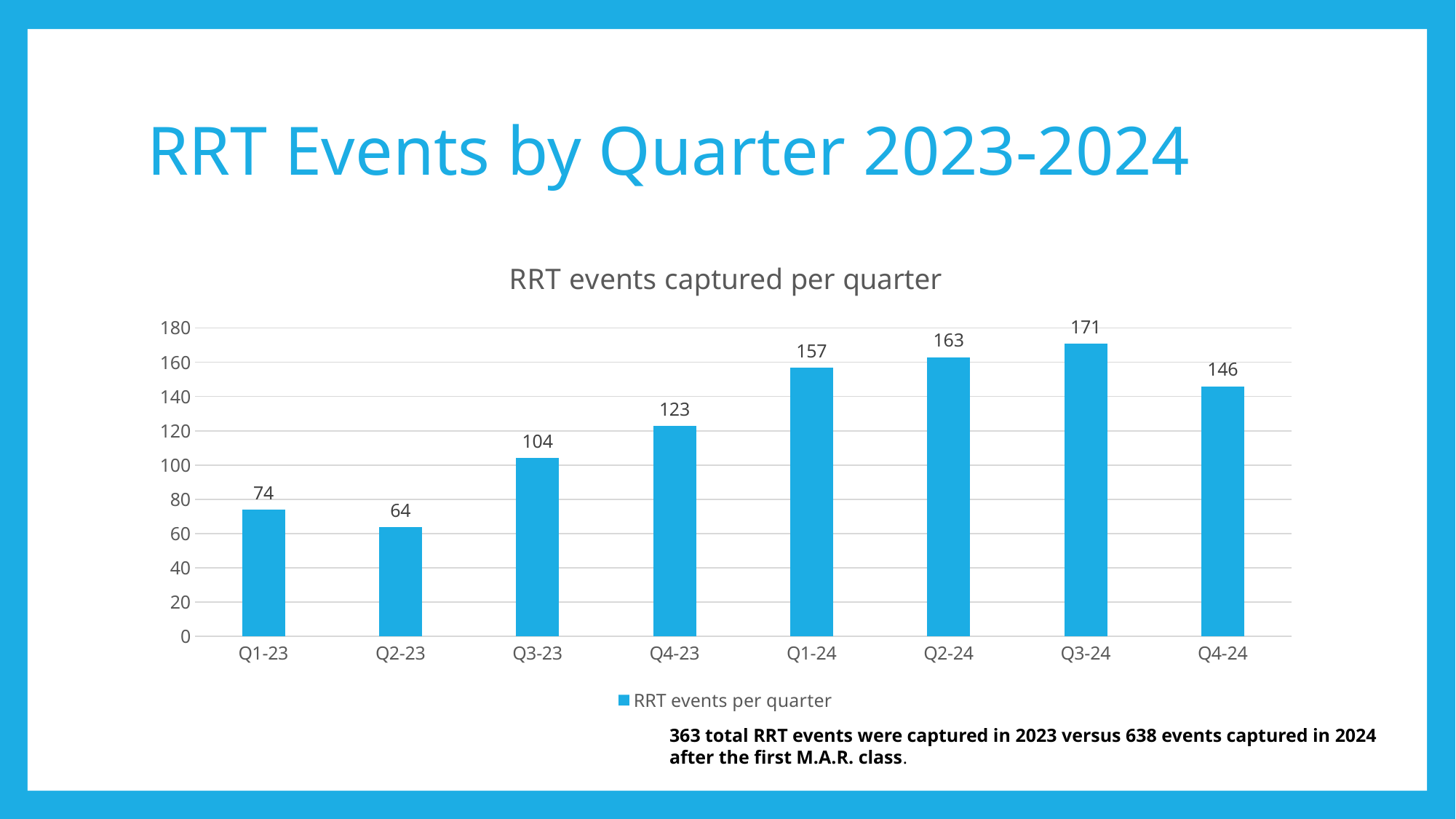
Is the value for Q3-23 greater or less than 100? greater Which quarter has the highest number of RRT events? Q3-24 Which is larger, the value for Q2-24 or the value for Q4-24? Q2-24 Which quarter has the lowest number of RRT events? Q2-23 What is the value for Q4-23? 123 What is the value for Q1-23? 74 What kind of chart is shown on the slide? bar chart What is the difference between the values for Q1-24 and Q4-23? 34 How many quarters are shown on the x axis? 8 What is the value for Q3-24? 171 What is the difference between the values for Q3-24 and Q2-23? 107 What is the title of the chart? RRT events captured per quarter